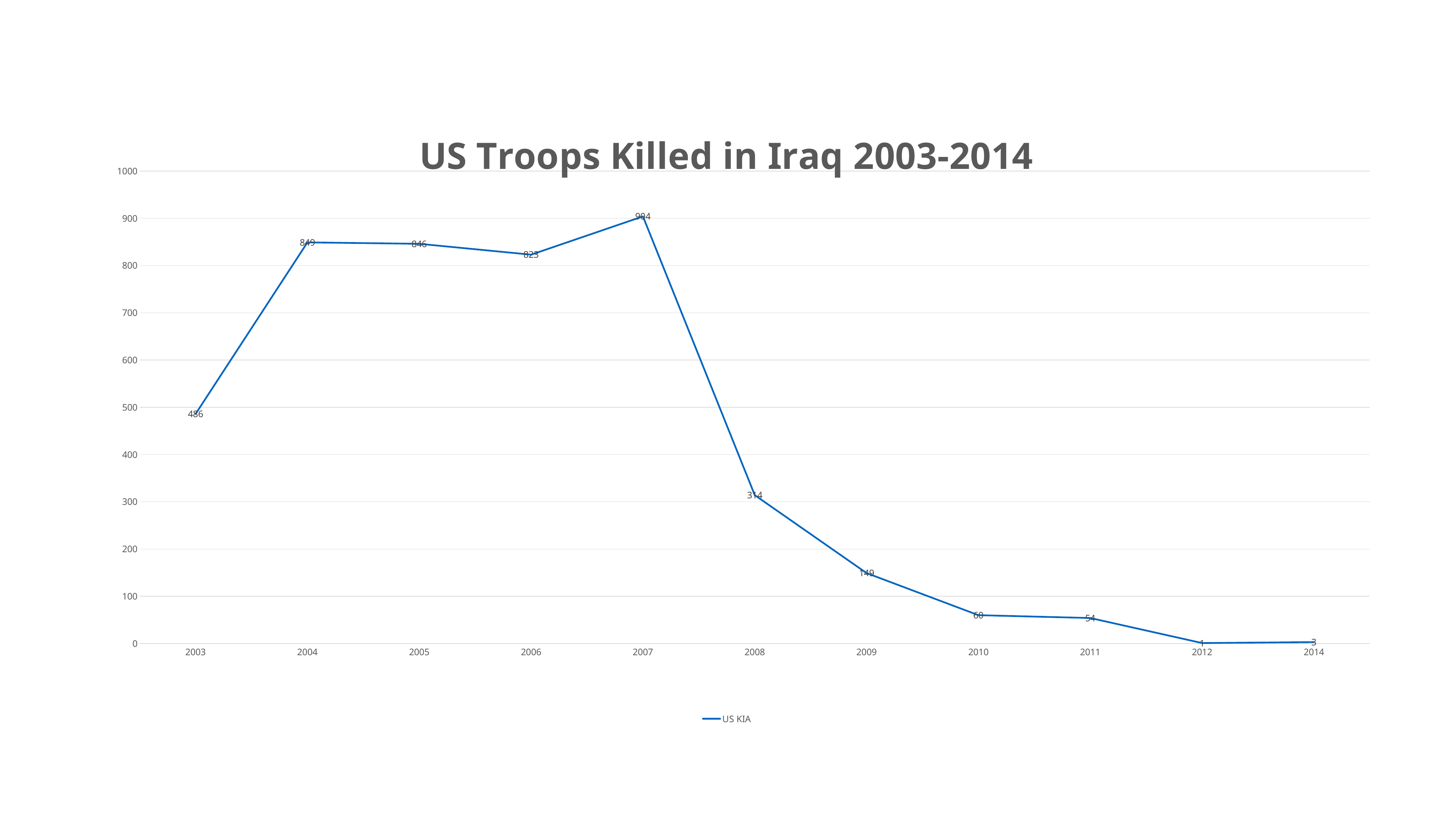
What is the name of the series shown in the legend? US KIA How many series does the legend list? 1 What is the value for 2003? 486 Which is larger, the value for 2004 or the value for 2006? 2004 Is the value for 2008 greater or less than 400? less What is the value for 2009? 149 Which year has the lowest value? 2012 What is the value for 2007? 904 What is the difference between the values for 2007 and 2008? 590 Which year has the highest value? 2007 What kind of chart is this? line chart How many years are plotted on the x axis? 11